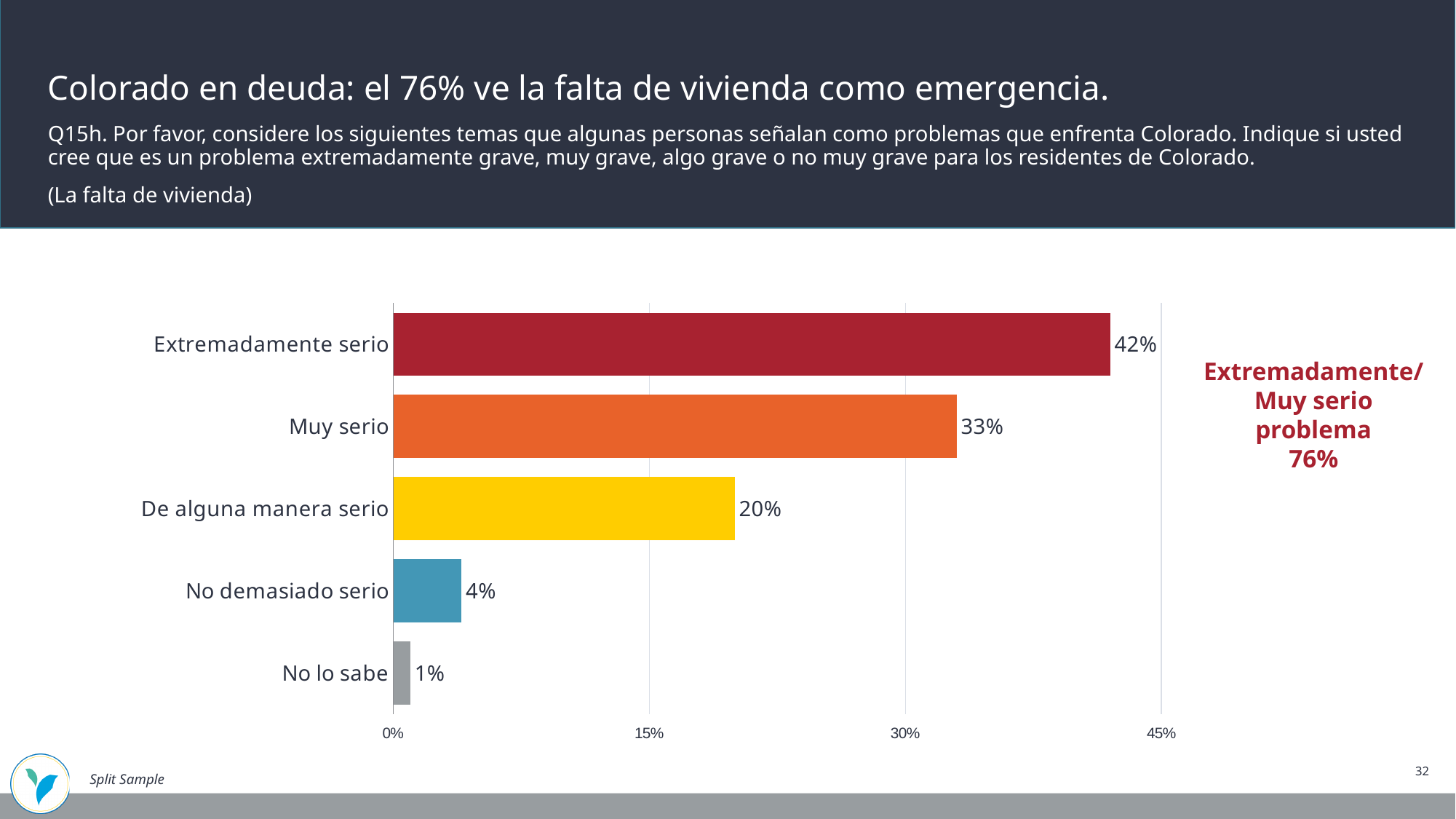
How many categories are shown in the chart? 5 What is the value for "Muy serio"? 33% What is the value for "Extremadamente serio"? 42% What is the value for "De alguna manera serio"? 20% Which is larger, the value for "De alguna manera serio" or the value for "No demasiado serio"? De alguna manera serio Is the value for "Muy serio" greater or less than 30%? greater Which category has the lowest value? No lo sabe What is the difference between the values for "Extremadamente serio" and "Muy serio"? 9% Which category has the highest value? Extremadamente serio What kind of chart is shown on the slide? bar chart What is the value for "No lo sabe"? 1% What combined percentage does the annotation next to the chart give for "Extremadamente/Muy serio problema"? 76%